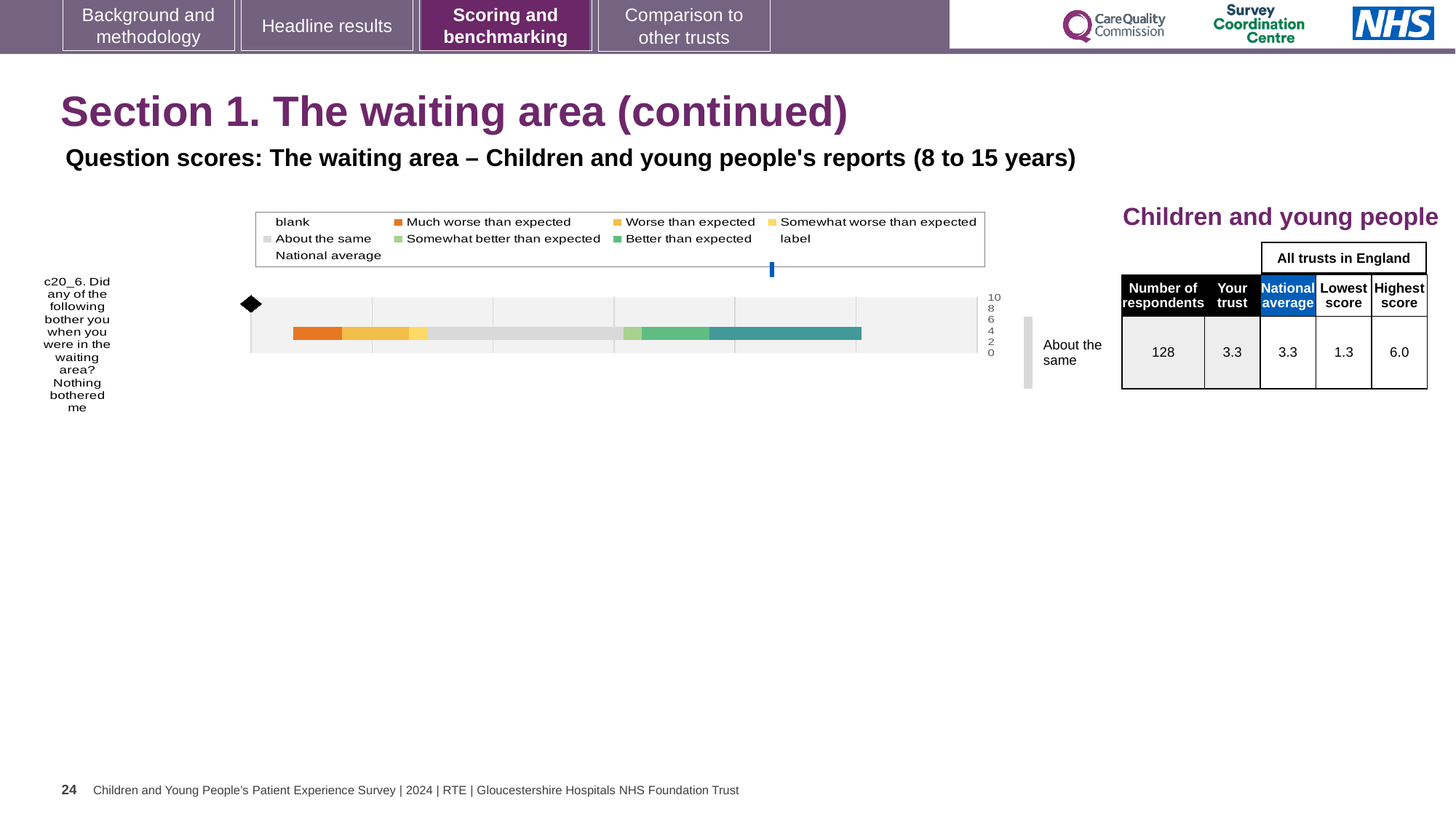
What is the national average score shown next to the chart for question c20_6? 3.3 What is the highest tick value shown on the chart's axis? 10 What colour does the legend use for 'Much worse than expected'? orange What is the difference between the highest score and the lowest score shown for question c20_6? 4.7 How many question categories are plotted on the chart? 1 How many entries does the chart legend list? 9 Which question is plotted on the chart? c20_6. Did any of the following bother you when you were in the waiting area? Nothing bothered me What kind of chart is shown on the slide? bar chart What benchmark category is shown beside the chart for question c20_6? About the same Is the 'Your trust' score for c20_6 larger or smaller than the highest score across all trusts in England? smaller What is the 'Your trust' score shown next to the chart for question c20_6? 3.3 What is the number of respondents shown for question c20_6? 128